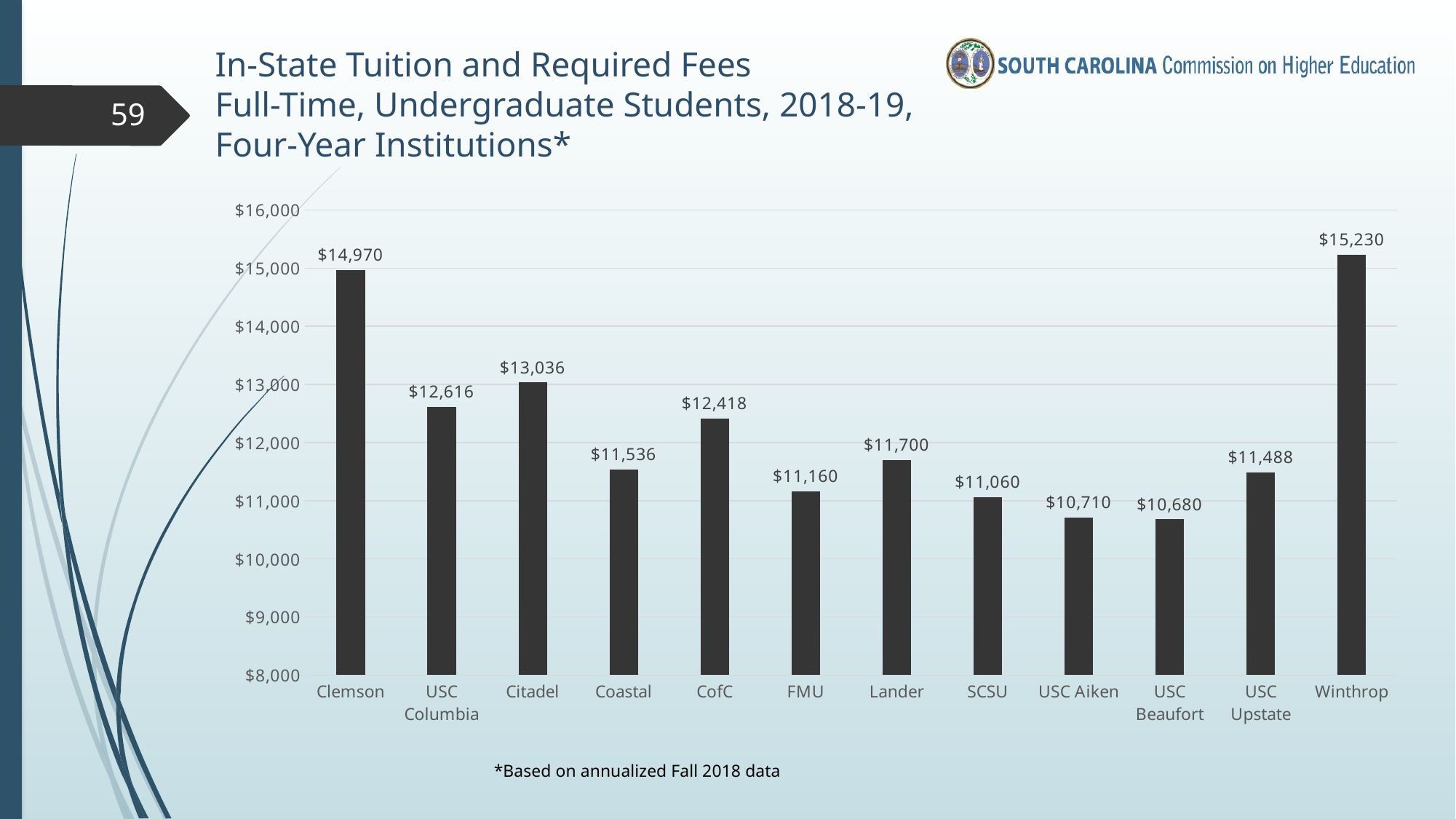
Which is larger, the value for Lander or the value for Coastal? Lander Is the value for FMU greater or less than $12,000? less What is the value shown for USC Columbia? $12,616 Which institution has the highest in-state tuition and required fees? Winthrop What is the in-state tuition and required fees value for Clemson? $14,970 What is the value shown for USC Beaufort? $10,680 What kind of chart is shown on the slide? bar chart What is the difference between Citadel's and CofC's values? $618 What is the difference between Winthrop's and Clemson's values? $260 How many institutions are shown on the chart? 12 Which institution has the lowest in-state tuition and required fees? USC Beaufort According to the footnote, what data is the chart based on? Annualized Fall 2018 data